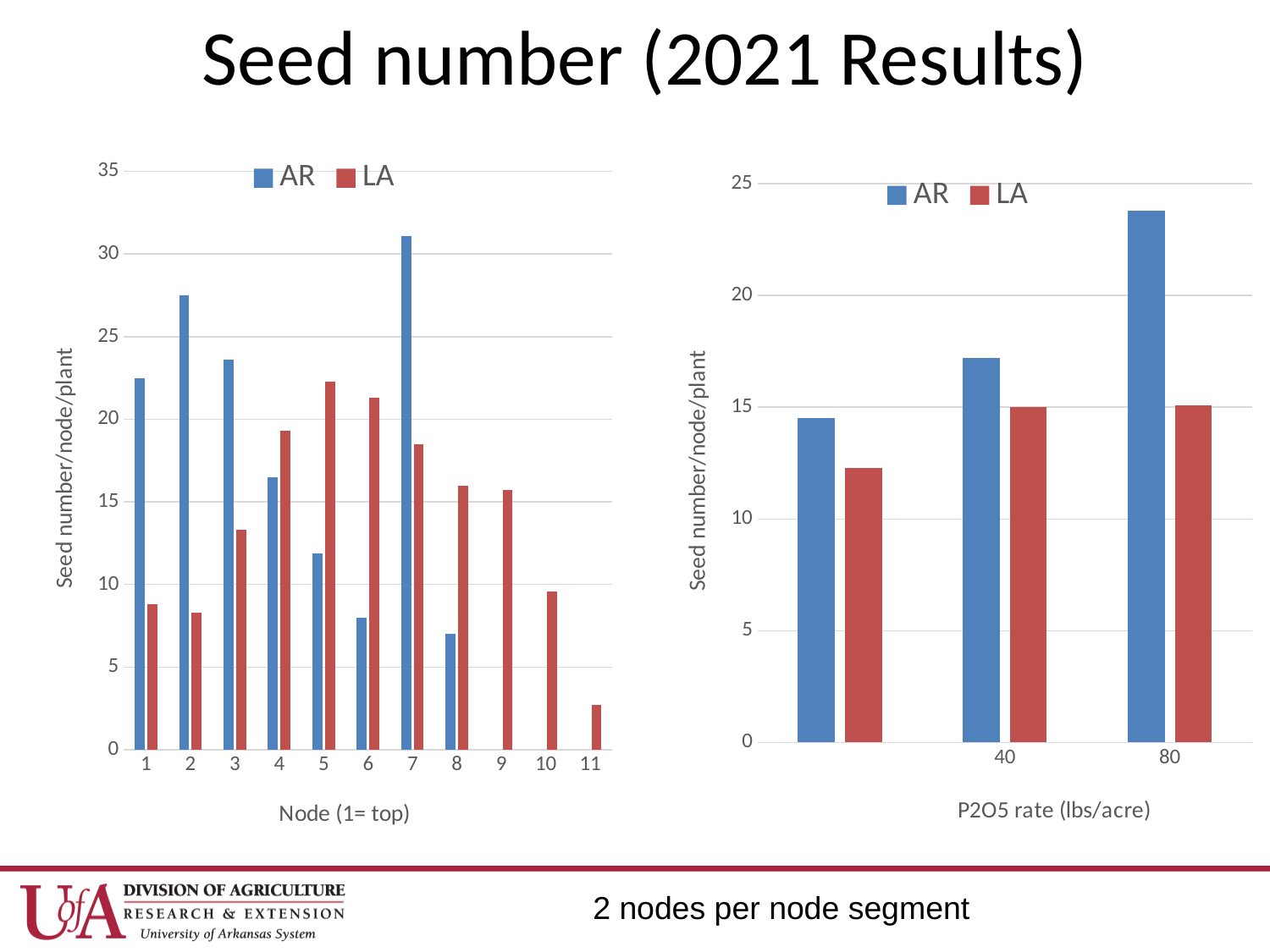
In the left chart (Node), is the LA value at node 1 greater or less than 10? less In the left chart (Node), is the AR value at node 7 greater or less than 30? greater In the left chart (Node), at which node is the LA value highest? 5 How many nodes are shown on the x axis of the left chart? 11 In the left chart (Node), at which node is the AR value highest? 7 How many series does the legend of the right chart list? 2 In the right chart (P2O5 rate), which is larger at 40 lbs/acre, AR or LA? AR In the right chart (P2O5 rate), does the AR value rise or fall as the P2O5 rate increases? rise In the right chart (P2O5 rate), is the AR value at 80 lbs/acre greater or less than 20? greater In the right chart (P2O5 rate), at which P2O5 rate is the AR value highest? 80 In the left chart (Node), at which node is the LA value lowest? 11 In the left chart (Node), which is larger at node 4, AR or LA? LA